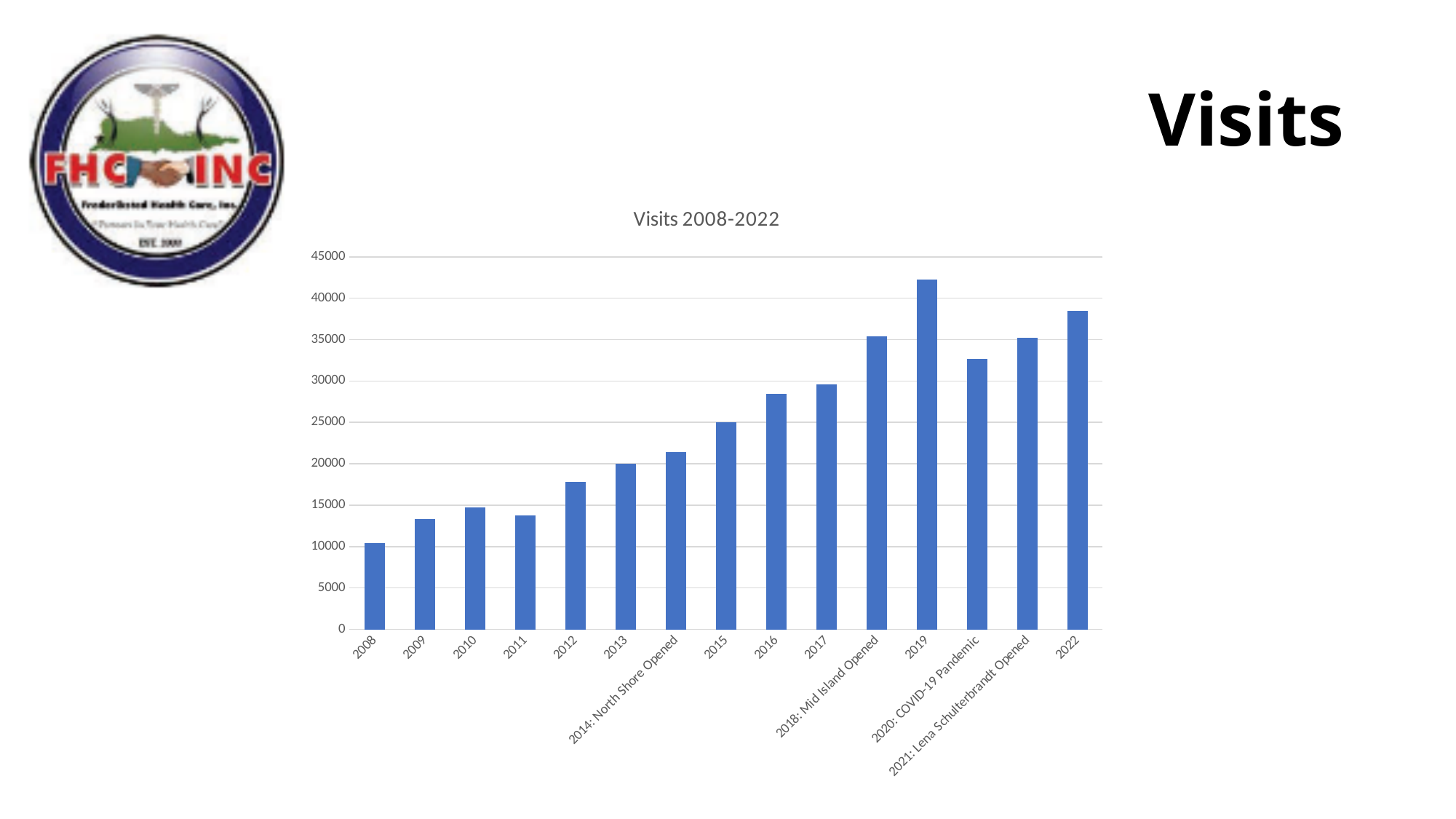
Is the value for 2020: COVID-19 Pandemic greater or less than 30000? greater What is the title of the chart? Visits 2008-2022 Which year has the highest number of visits? 2019 Is the value for 2008 greater or less than 15000? less Is the value for 2012 greater or less than 20000? less Overall, do visits rise or fall from 2008 to 2022? rise Which has more visits, 2022 or 2020: COVID-19 Pandemic? 2022 What kind of chart is shown on the slide? bar chart How many bars (years) are plotted in the chart? 15 Which has more visits, 2010 or 2011? 2010 Which year has the lowest number of visits? 2008